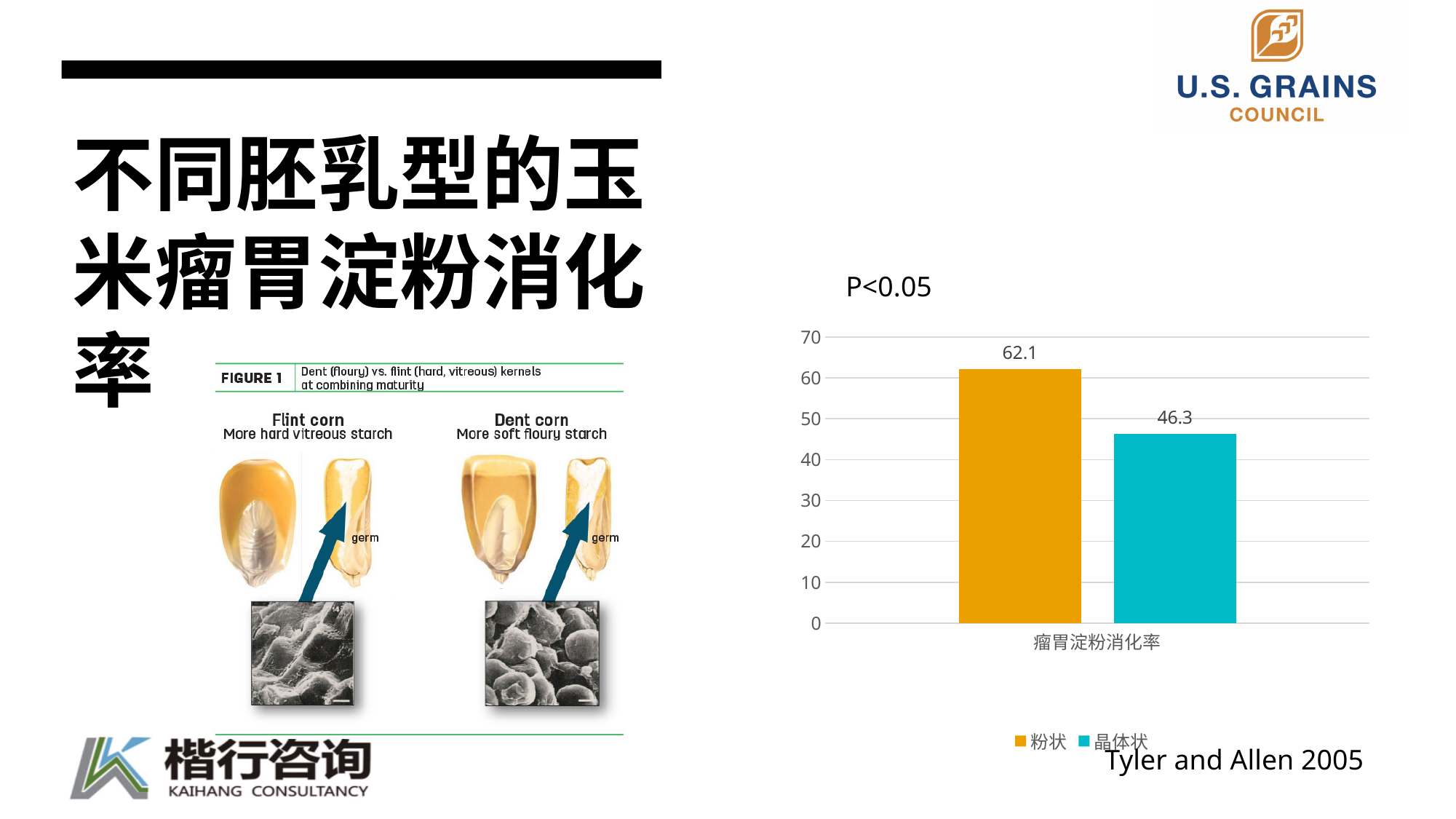
What is the highest value shown on the y axis of the bar chart? 70 Which series has the higher value in the bar chart, 粉状 or 晶体状? 粉状 What is the category label shown on the x axis of the bar chart? 瘤胃淀粉消化率 What colour is the bar for 晶体状 in the chart? teal Which series has the lowest value in the bar chart? 晶体状 Is the value for 粉状 greater or less than 60? greater What is the difference between the values for 粉状 and 晶体状 in the bar chart? 15.8 What is the value for 晶体状 in the bar chart? 46.3 How many series does the legend of the bar chart list? 2 What is the value for 粉状 in the bar chart? 62.1 What type of chart is shown on the slide? bar chart Is the value for 晶体状 greater or less than 50? less